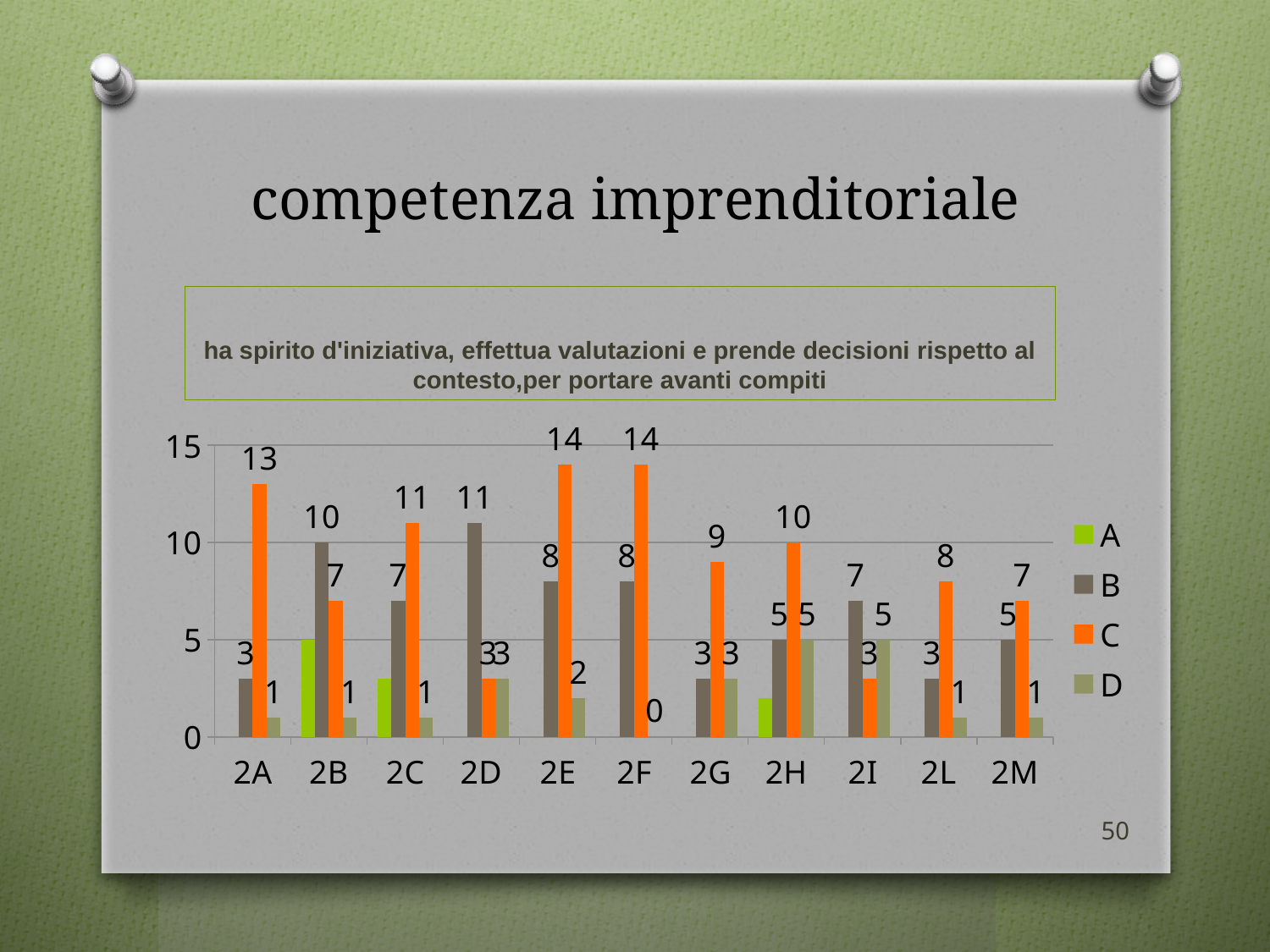
Which category has the lowest value for series D? 2F What kind of chart is shown on the slide? bar chart Which category has the highest value for series B? 2D For category 2E, what is the difference between the value of series C and the value of series B? 6 What is the value of series D for category 2I? 5 Is the value of series A for category 2C greater or less than 5? less How many series does the legend list? 4 What is the value of series C for category 2A? 13 For category 2B, which series has the larger value, B or C? B What is the value of series B for category 2D? 11 How many categories are shown on the x axis? 11 What colour are the bars for series C? orange